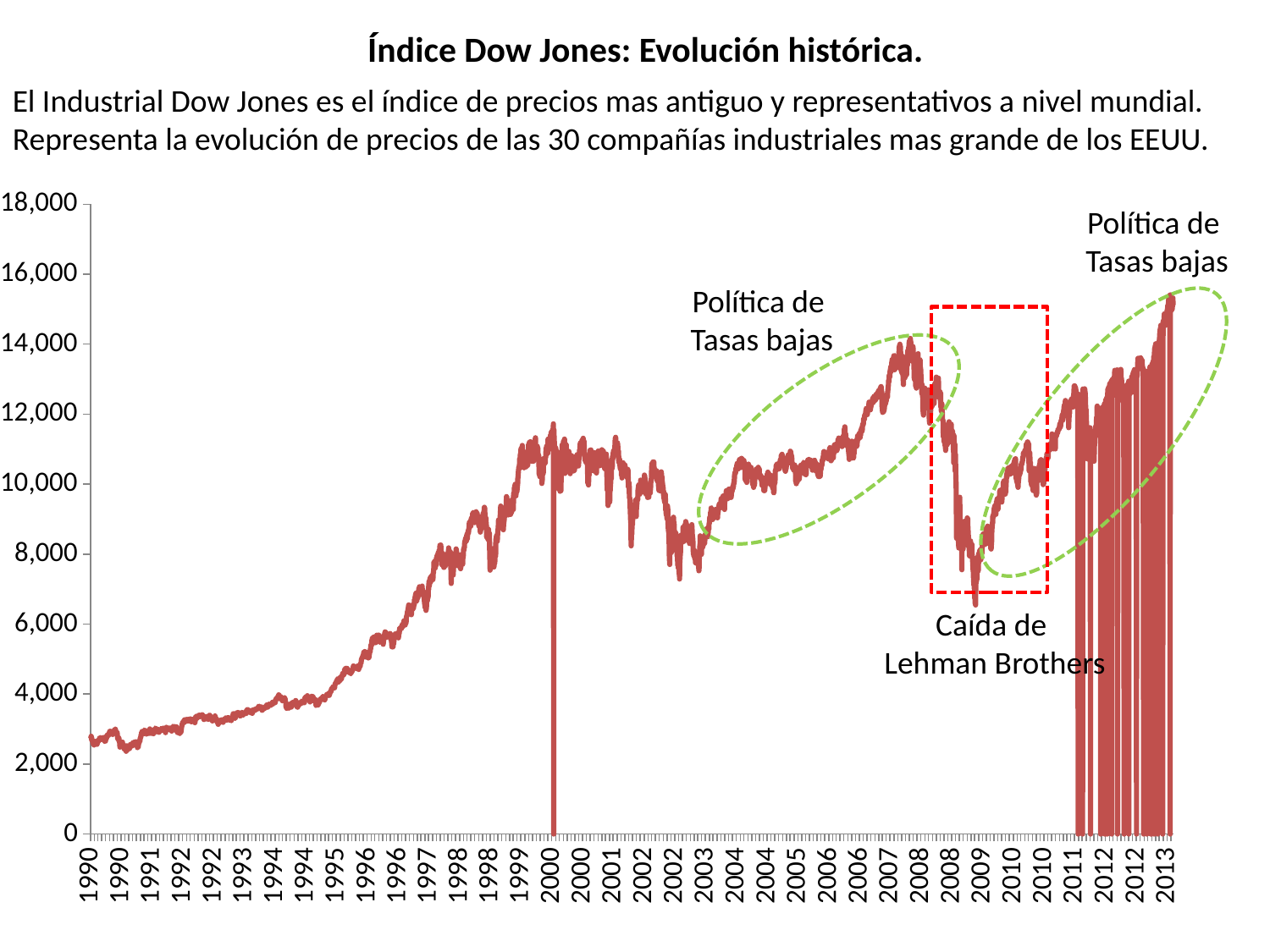
Is the value of the index in 1999 greater or less than 10,000? greater Overall, does the Dow Jones index rise or fall from 1990 to 2013 along the x axis? rise Is the lowest value of the index in 2009 greater or less than 8,000? less In which year does the index reach its highest value on the chart? 2013 Is the value of the index at the end of 2013 greater or less than 14,000? greater Which is larger, the index value in 1990 or in 2000? 2000 What is the title of the chart on the slide? Índice Dow Jones: Evolución histórica. What event is labelled inside the red dashed box on the chart? Caída de Lehman Brothers What kind of chart is shown on the slide? line chart